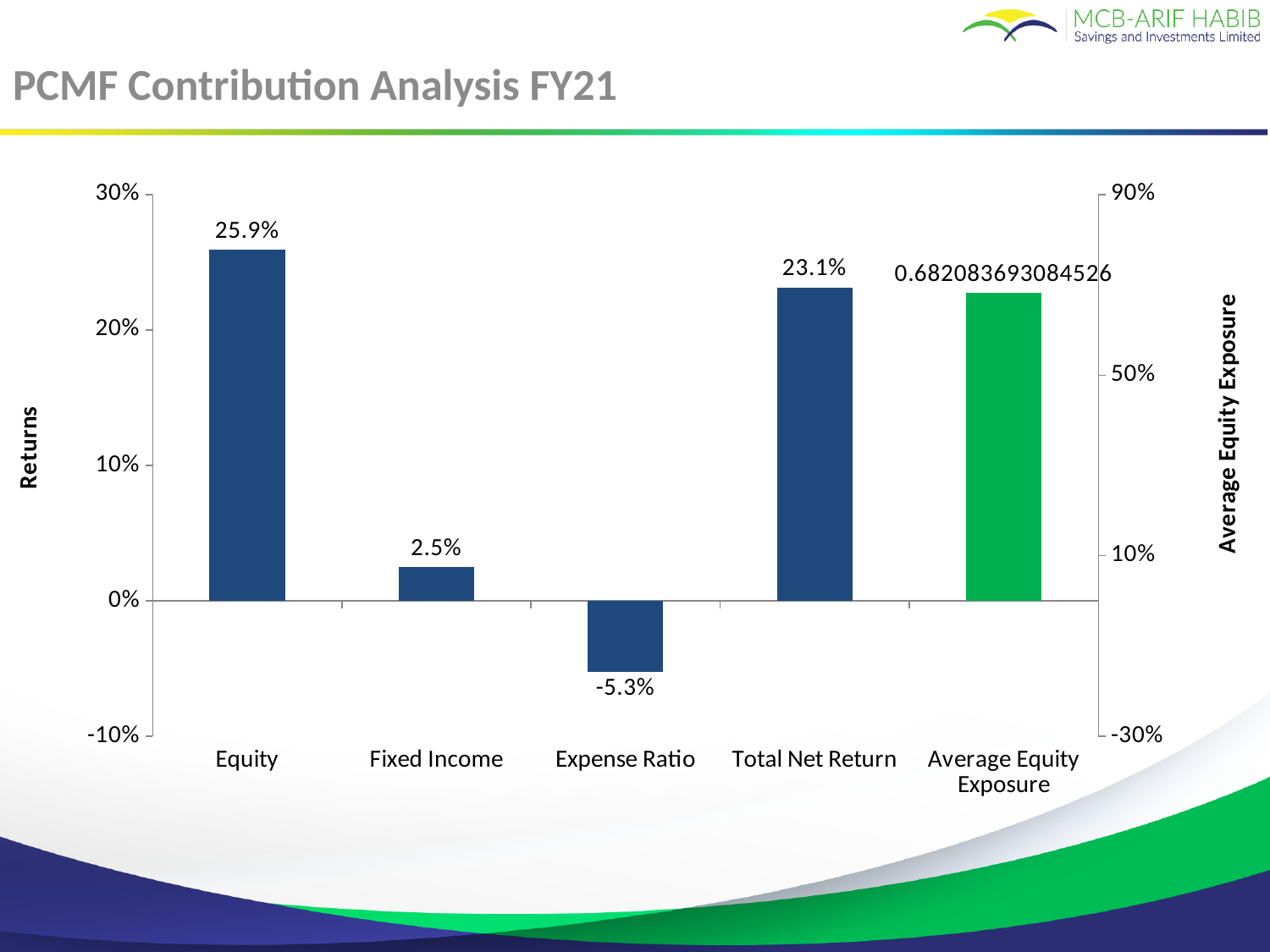
What is the difference between the Equity value and the Total Net Return value? 2.8% What is the title of the left vertical axis? Returns Which is larger, the value for Fixed Income or the value for Total Net Return? Total Net Return Among the blue Returns bars, which category has the lowest value? Expense Ratio What data label is printed above the Average Equity Exposure bar? 0.682083693084526 What is the value shown for Total Net Return? 23.1% What is the value shown for Expense Ratio? -5.3% What type of chart is shown on the slide? Bar chart What is the value shown for Fixed Income? 2.5% What is the value shown for Equity? 25.9% How many categories are shown on the x axis? 5 Among the blue Returns bars, which category has the highest value? Equity